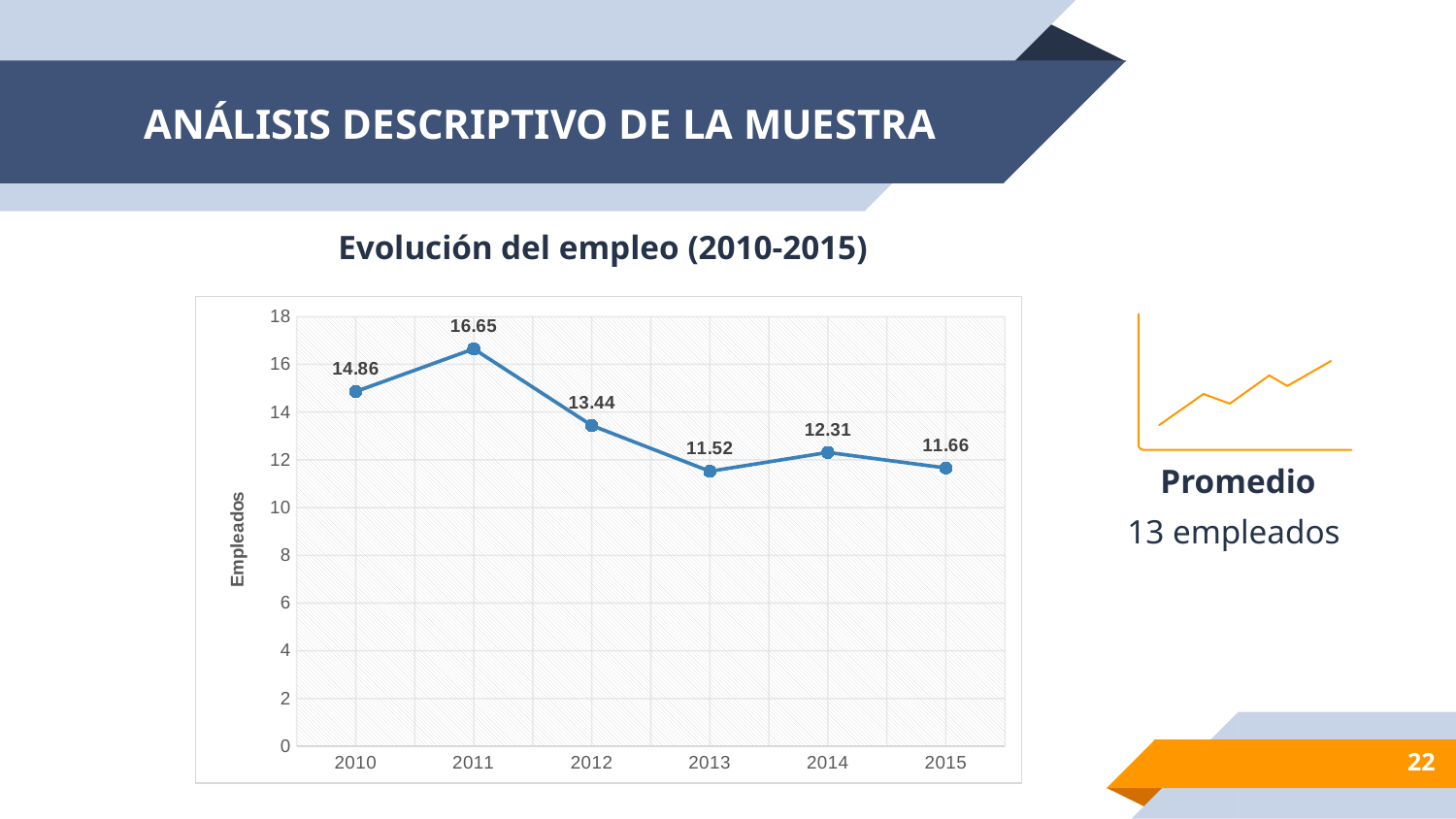
What kind of chart is shown? line chart How many years are plotted on the chart? 6 Which is larger, the value for 2014 or the value for 2015? 2014 Which year has the highest value? 2011 Which year has the lowest value? 2013 Is the value for 2012 greater or less than 14? less What is the value for 2010? 14.86 What is the value for 2015? 11.66 What is the difference between the values for 2010 and 2015? 3.2 What is the value for 2013? 11.52 What is the title of the chart? Evolución del empleo (2010-2015) What is the difference between the values for 2011 and 2012? 3.21